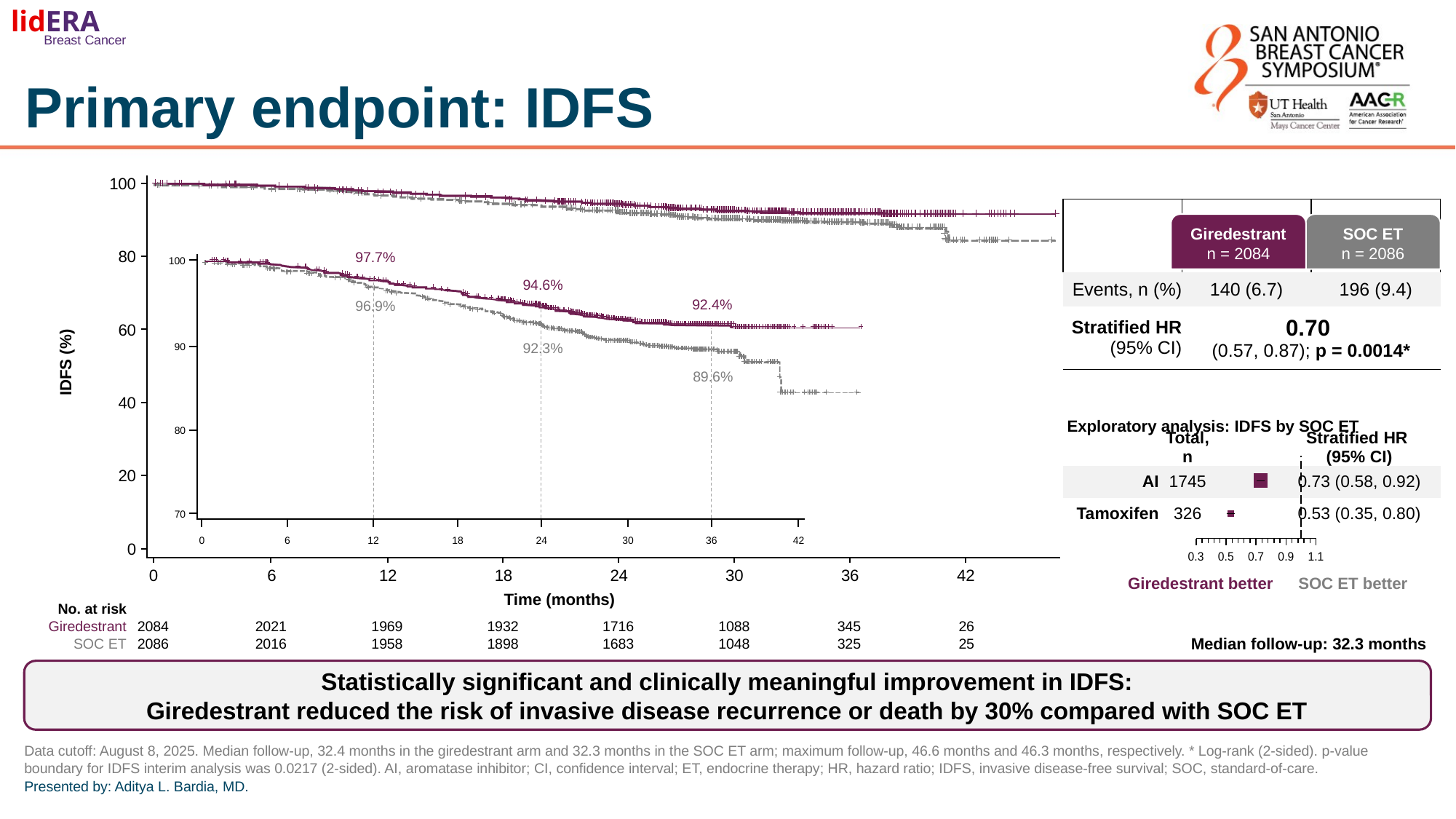
In the IDFS Kaplan-Meier chart, do the curves rise or fall as time in months increases? Fall In the IDFS Kaplan-Meier chart, what is the difference between the giredestrant and SOC ET IDFS rates at 36 months? 2.8 percentage points In the IDFS Kaplan-Meier chart, what is the IDFS rate for giredestrant at 36 months? 92.4% In the IDFS Kaplan-Meier chart, how many patients were at risk in the SOC ET arm at 30 months? 1048 In the exploratory analysis forest plot, what is the total n for the AI subgroup? 1745 In the IDFS Kaplan-Meier chart, which arm has the higher IDFS rate at 24 months? Giredestrant What kind of chart is the main IDFS plot? Line chart (Kaplan-Meier survival curve) In the IDFS Kaplan-Meier chart, what is the difference between the giredestrant and SOC ET IDFS rates at 12 months? 0.8 percentage points In the exploratory analysis forest plot, what is the stratified HR (95% CI) for the tamoxifen subgroup? 0.53 (0.35, 0.80) In the IDFS Kaplan-Meier chart, how many patients were at risk in the giredestrant arm at 24 months? 1716 How many treatment arms (series) are plotted in the IDFS Kaplan-Meier chart? 2 In the IDFS Kaplan-Meier chart, what is the IDFS rate for SOC ET at 24 months? 92.3%